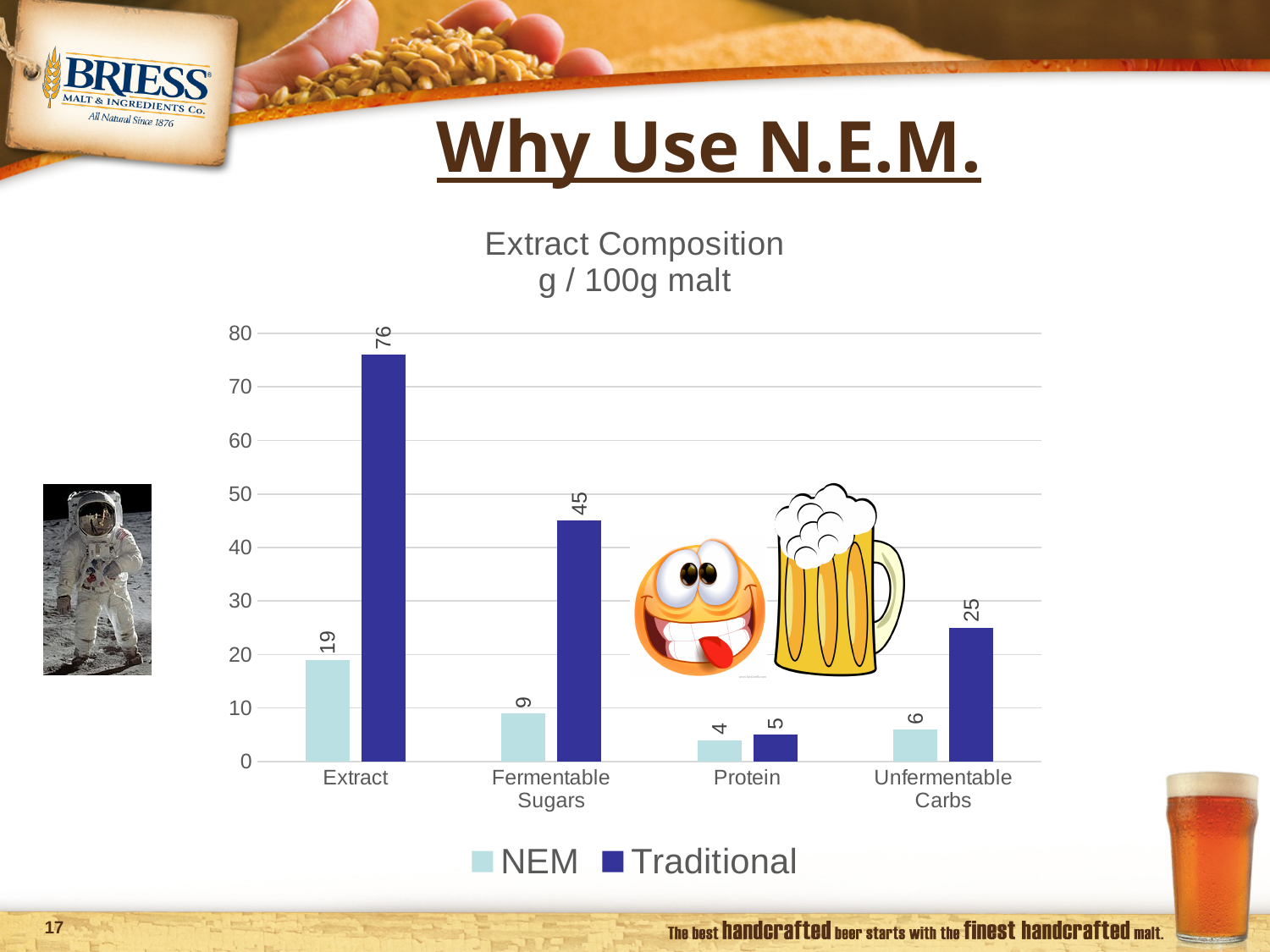
What kind of chart is shown on the slide? Bar chart What is the difference between the Traditional and NEM values for Extract? 57 How many categories are shown on the x axis? 4 What is the NEM value for Protein? 4 What is the Traditional value for Extract? 76 Which category has the highest Traditional value? Extract Which category has the lowest NEM value? Protein How many series does the legend list? 2 What unit is given in the chart title? g / 100g malt What is the NEM value for Fermentable Sugars? 9 Which is larger for Fermentable Sugars, the NEM value or the Traditional value? Traditional What is the Traditional value for Unfermentable Carbs? 25